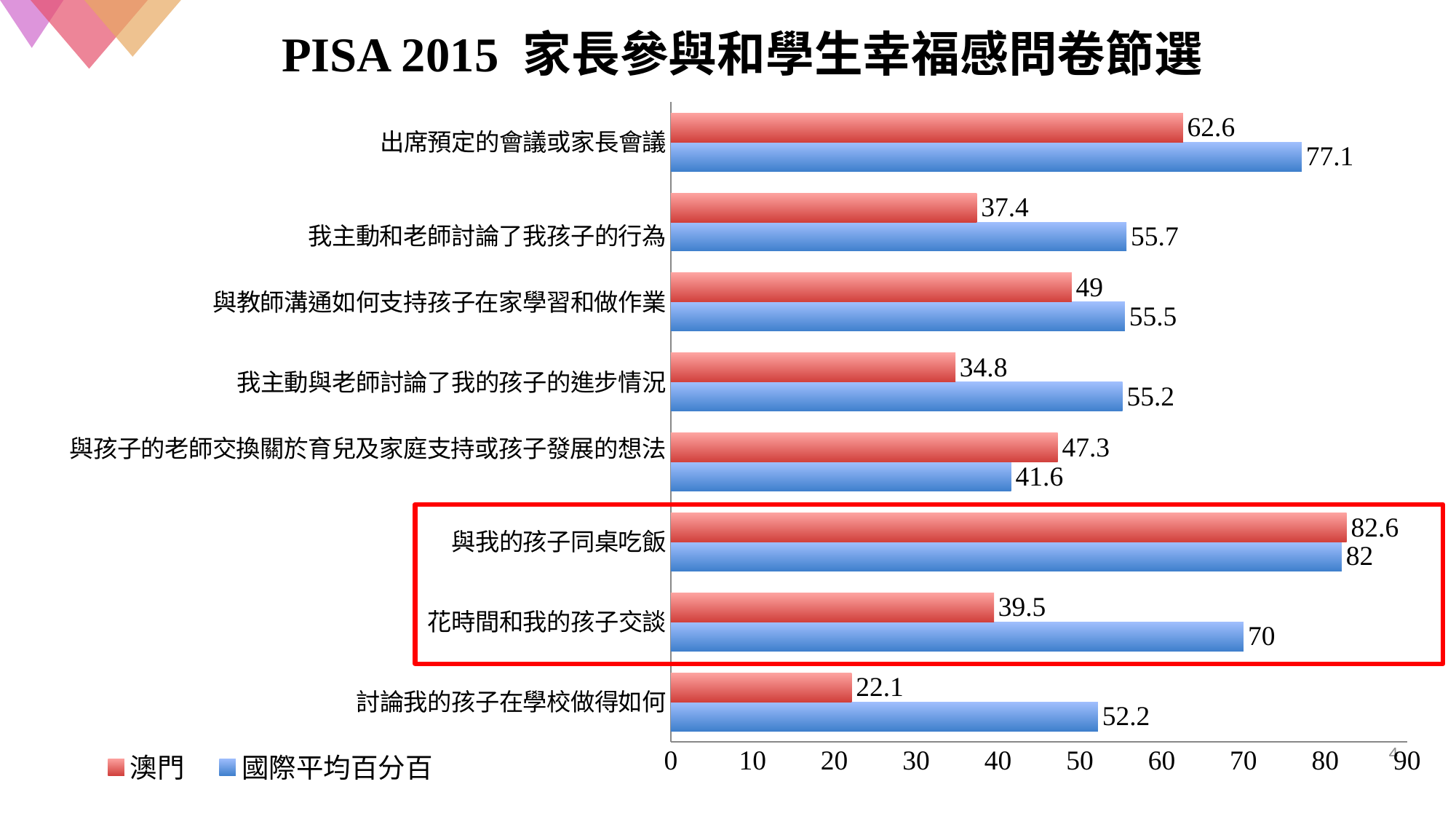
Which colour represents 國際平均百分百 in the chart? blue What is the 澳門 value for 出席預定的會議或家長會議? 62.6 What is the 澳門 value for 討論我的孩子在學校做得如何? 22.1 What kind of chart is shown on the slide? bar chart Is the 澳門 value for 我主動與老師討論了我的孩子的進步情況 greater or less than 40? less What is the difference between the 國際平均百分百 and 澳門 values for 花時間和我的孩子交談? 30.5 What is the 國際平均百分百 value for 花時間和我的孩子交談? 70 For 與孩子的老師交換關於育兒及家庭支持或孩子發展的想法, which is larger: the 澳門 value or the 國際平均百分百 value? 澳門 How many categories are shown on the chart? 8 How many series does the legend list? 2 Which category has the lowest 國際平均百分百 value? 與孩子的老師交換關於育兒及家庭支持或孩子發展的想法 Which category has the highest 澳門 value? 與我的孩子同桌吃飯